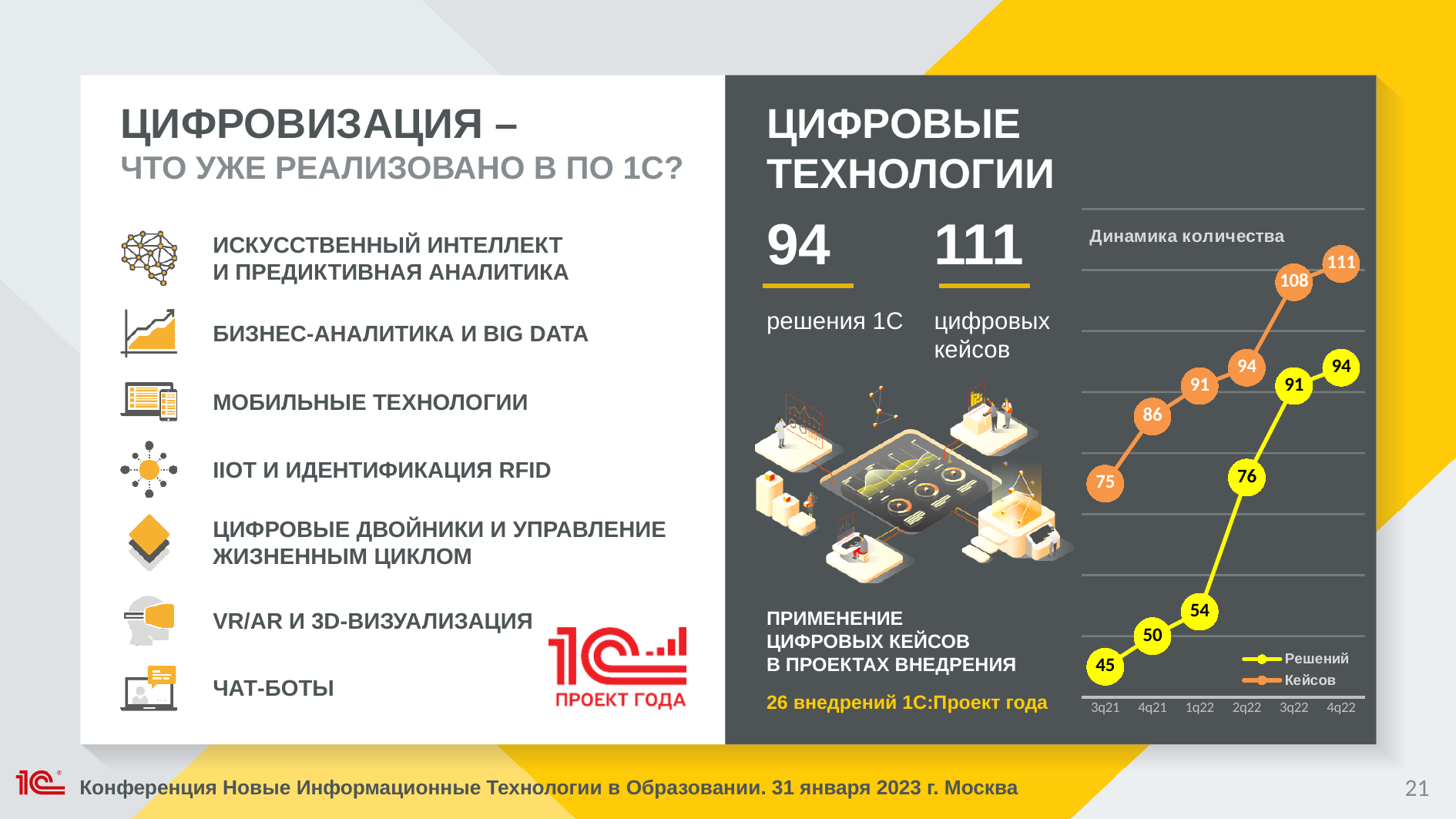
At which quarter is the "Решений" series lowest? 3q21 How many points along the x axis does the "Динамика количества" chart have? 6 What is the value of the "Решений" series at 3q21? 45 At which quarter is the "Кейсов" series highest? 4q22 Does the "Решений" series rise or fall from 3q21 to 4q22? rise What is the value of the "Решений" series at 2q22? 76 What is the difference between the "Кейсов" and "Решений" values at 3q21? 30 What is the value of the "Кейсов" series at 1q22? 91 Which series has the larger value at 3q22, "Решений" or "Кейсов"? Кейсов How many series does the legend of the "Динамика количества" chart list? 2 What is the value of the "Кейсов" series at 4q22? 111 What type of chart is shown under the title "Динамика количества"? line chart